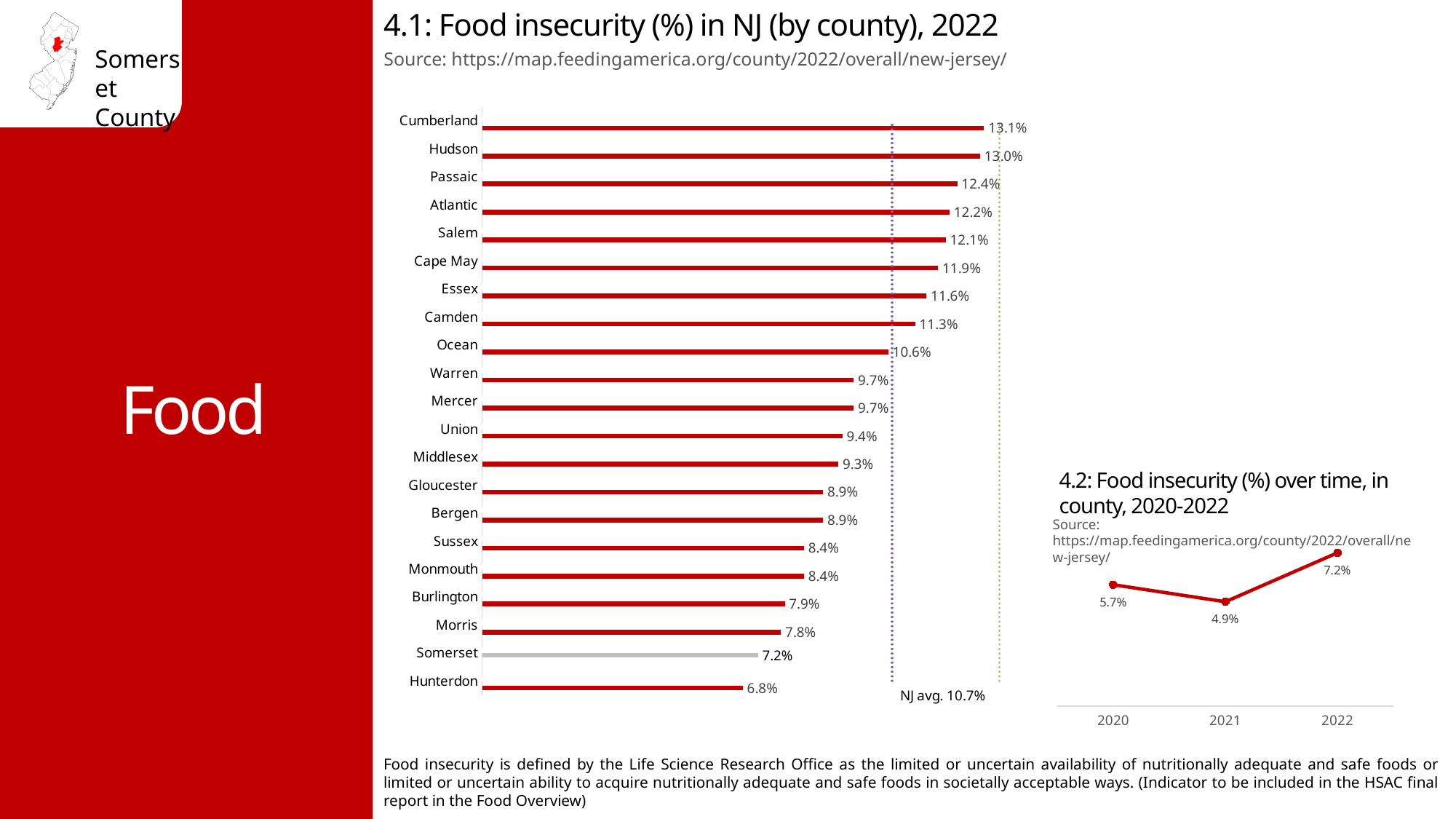
In chart 4.1 (Food insecurity in NJ by county, 2022), how many counties are shown? 21 In chart 4.1 (Food insecurity in NJ by county, 2022), what NJ average value is labelled on the chart? 10.7% In chart 4.1 (Food insecurity in NJ by county, 2022), which county has the lowest value? Hunterdon In chart 4.1 (Food insecurity in NJ by county, 2022), what is the difference between Cumberland and Hunterdon? 6.3% In chart 4.1 (Food insecurity in NJ by county, 2022), what is the value for Essex? 11.6% In chart 4.1 (Food insecurity in NJ by county, 2022), which is larger, the value for Passaic or the value for Ocean? Passaic In chart 4.1 (Food insecurity in NJ by county, 2022), what is the value for Somerset? 7.2% What kind of chart is chart 4.1 (Food insecurity in NJ by county, 2022)? Bar chart In chart 4.2 (Food insecurity over time, 2020-2022), what is the value for 2021? 4.9% In chart 4.1 (Food insecurity in NJ by county, 2022), which county has the highest value? Cumberland What kind of chart is chart 4.2 (Food insecurity over time, 2020-2022)? Line chart In chart 4.2 (Food insecurity over time, 2020-2022), what is the difference between the 2022 and 2020 values? 1.5%